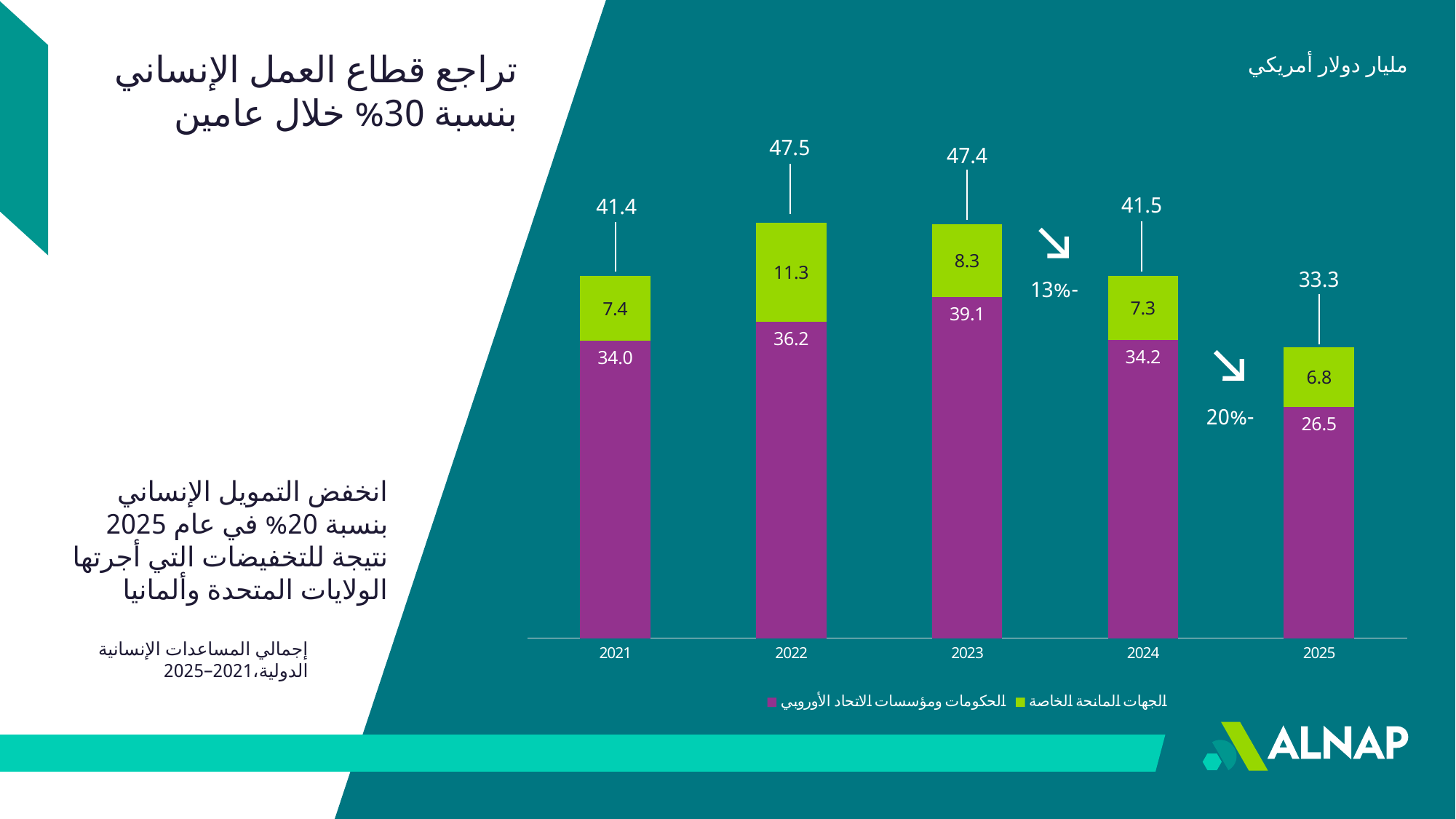
Which year has the highest value for the green segment (الجهات المانحة الخاصة)? 2022 Is the purple segment (الحكومات ومؤسسات الاتحاد الأوروبي) larger in 2022 or in 2024? 2022 What is the value of the green segment (الجهات المانحة الخاصة) for 2025? 6.8 Which year has the lowest total value? 2025 What is the total value of the stacked bar for 2022? 47.5 What kind of chart is shown on the slide? Stacked bar chart What is the difference between the total for 2024 and the total for 2025? 8.2 How many series does the legend list? 2 What unit is stated for the chart values in the top-right corner? مليار دولار أمريكي Do the total values rise or fall from 2023 to 2025? Fall How many years are shown on the x axis? 5 What is the value of the purple segment (الحكومات ومؤسسات الاتحاد الأوروبي) for 2023? 39.1